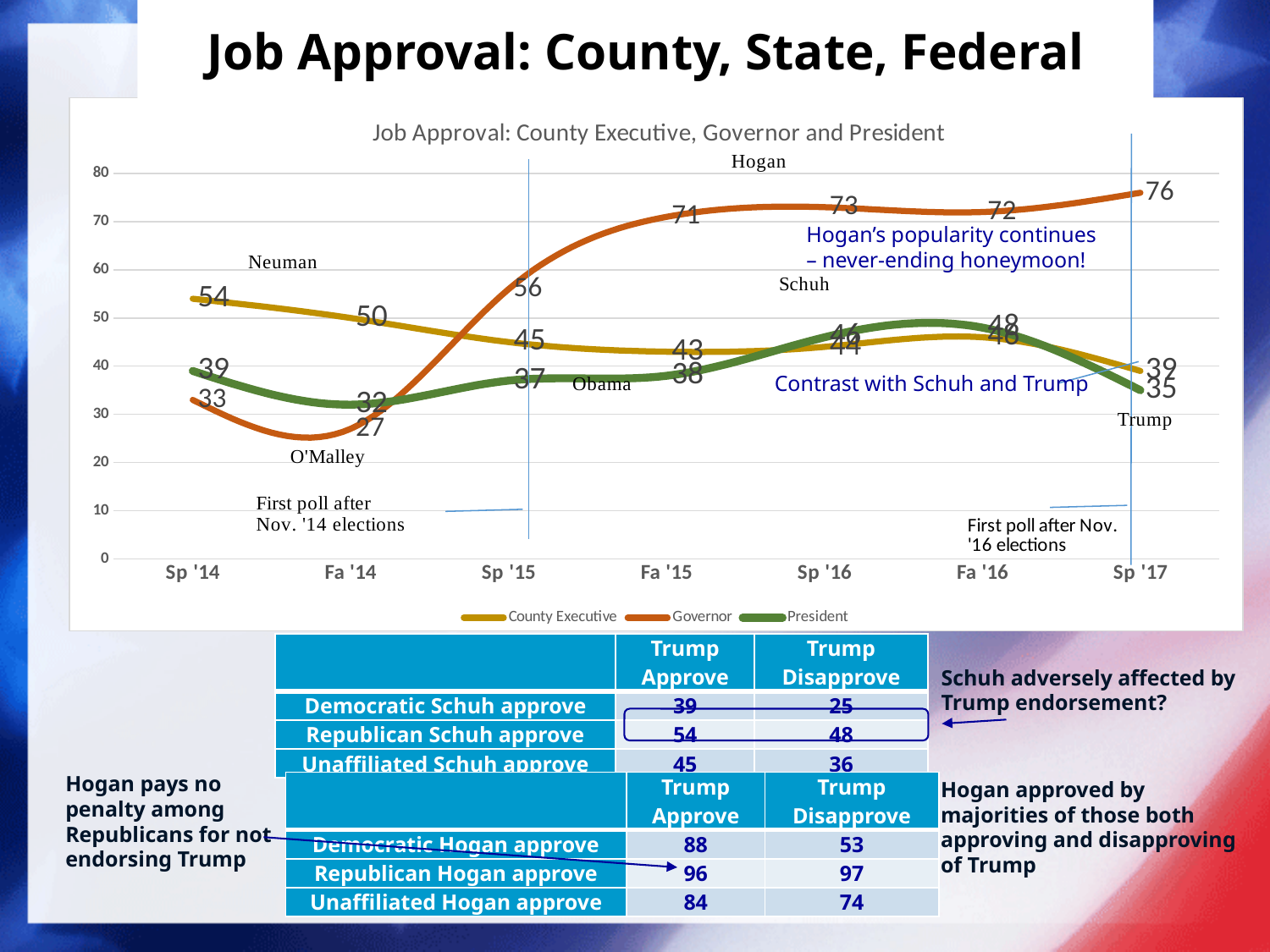
How many time points are shown on the x axis of the line chart? 7 What is the Governor approval value at Sp '17? 76 What is the difference between the Governor approval at Sp '17 and at Sp '14? 43 At Sp '15, which is larger: the Governor approval or the County Executive approval? Governor What is the Governor approval value at Fa '14? 27 Does the County Executive approval rise or fall from Sp '14 to Sp '15? fall What kind of chart is shown on the slide? line chart Is the President approval value at Sp '17 greater or less than 40? less What is the County Executive approval value at Sp '14? 54 At which time point is the Governor approval lowest? Fa '14 How many series does the legend of the line chart list? 3 At which time point is the Governor approval highest? Sp '17